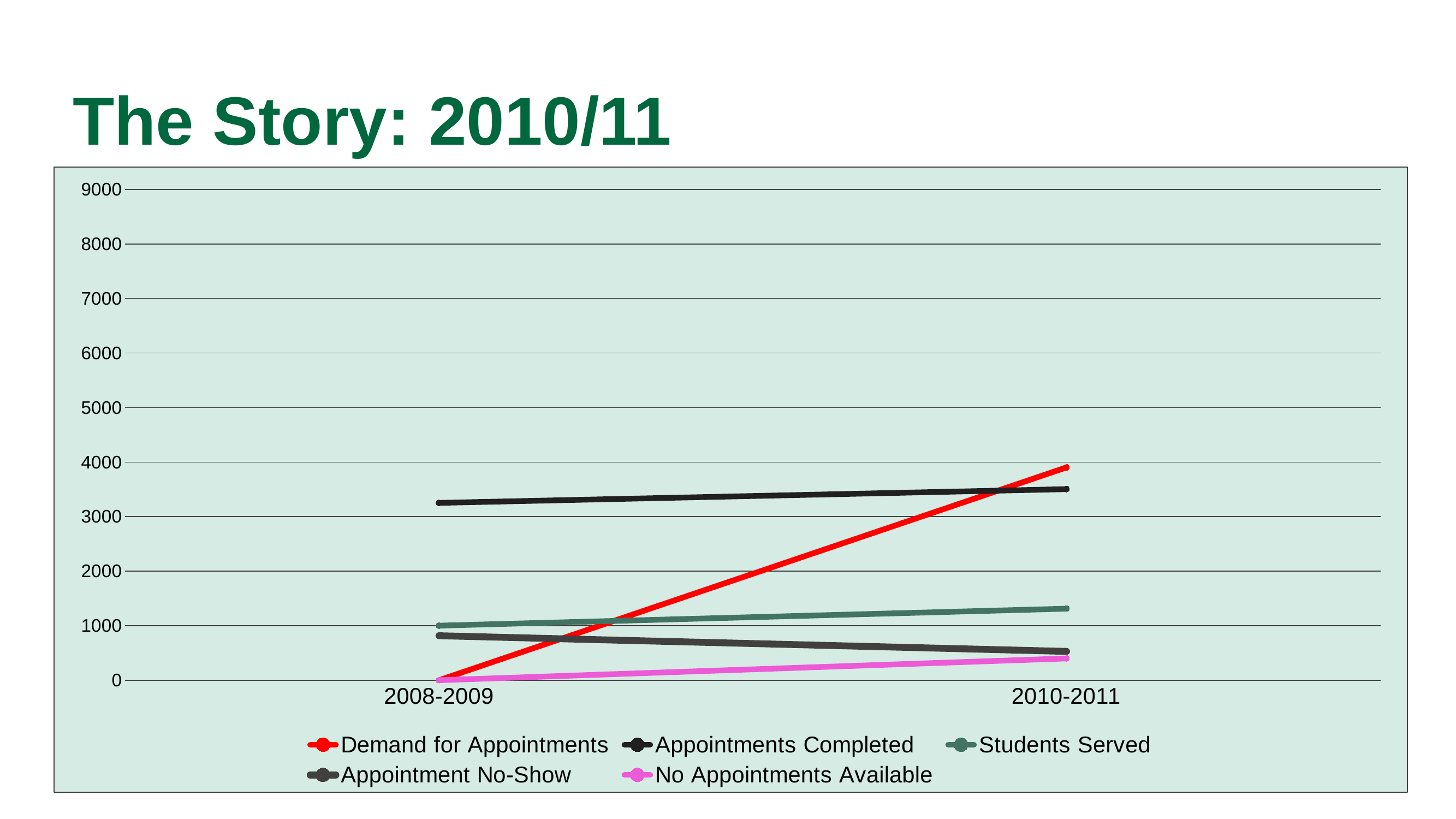
In 2010-2011, which is larger: Demand for Appointments or Appointments Completed? Demand for Appointments What colour is the Demand for Appointments line? red Does the Appointment No-Show line rise or fall from 2008-2009 to 2010-2011? fall Which series has the highest value in 2010-2011? Demand for Appointments Does the Demand for Appointments line rise or fall from 2008-2009 to 2010-2011? rise Which series has the highest value in 2008-2009? Appointments Completed Is the value for Students Served in 2010-2011 greater or less than 1000? greater How many series does the legend list? 5 Is the value for Appointments Completed in 2008-2009 greater or less than 3000? greater How many time periods are shown on the x axis? 2 What kind of chart is shown on the slide? line chart Is the value for Demand for Appointments in 2010-2011 greater or less than 3000? greater